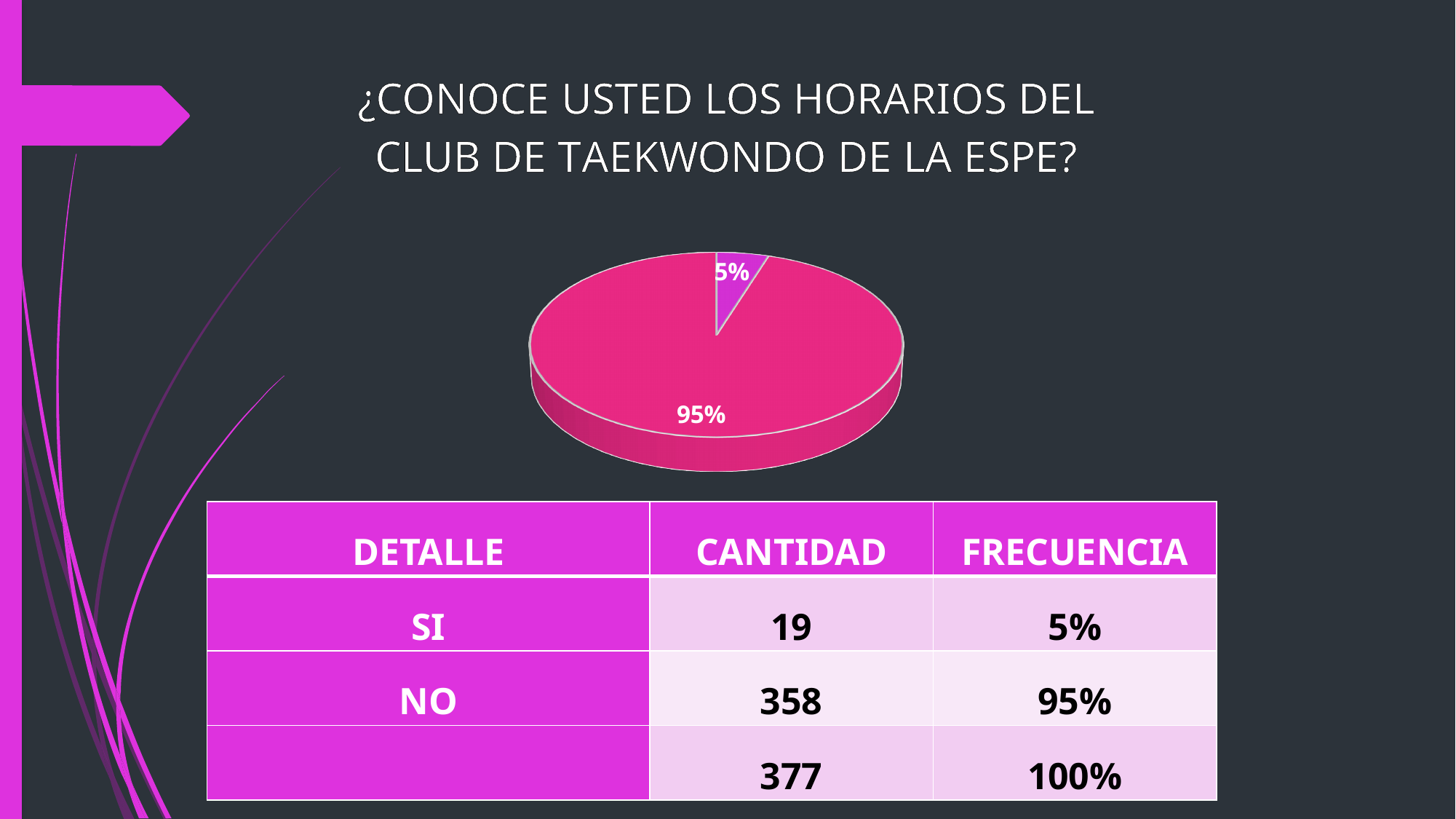
Which response, SI or NO, has the larger slice in the pie chart? NO What is the CANTIDAD value for NO in the table below the chart? 358 What is the difference in percentage points between the two slices of the pie chart? 90 percentage points What percentage is shown on the smaller slice of the pie chart? 5% Which response has the smallest share in the pie chart? SI What is the total CANTIDAD shown in the table below the chart? 377 According to the table, what share of the pie corresponds to NO? 95% What percentage is shown on the larger slice of the pie chart? 95% What question is the pie chart answering, according to the slide title? ¿CONOCE USTED LOS HORARIOS DEL CLUB DE TAEKWONDO DE LA ESPE? What type of chart is shown on the slide? pie chart How many slices does the pie chart have? 2 According to the table, what share of the pie corresponds to SI? 5%